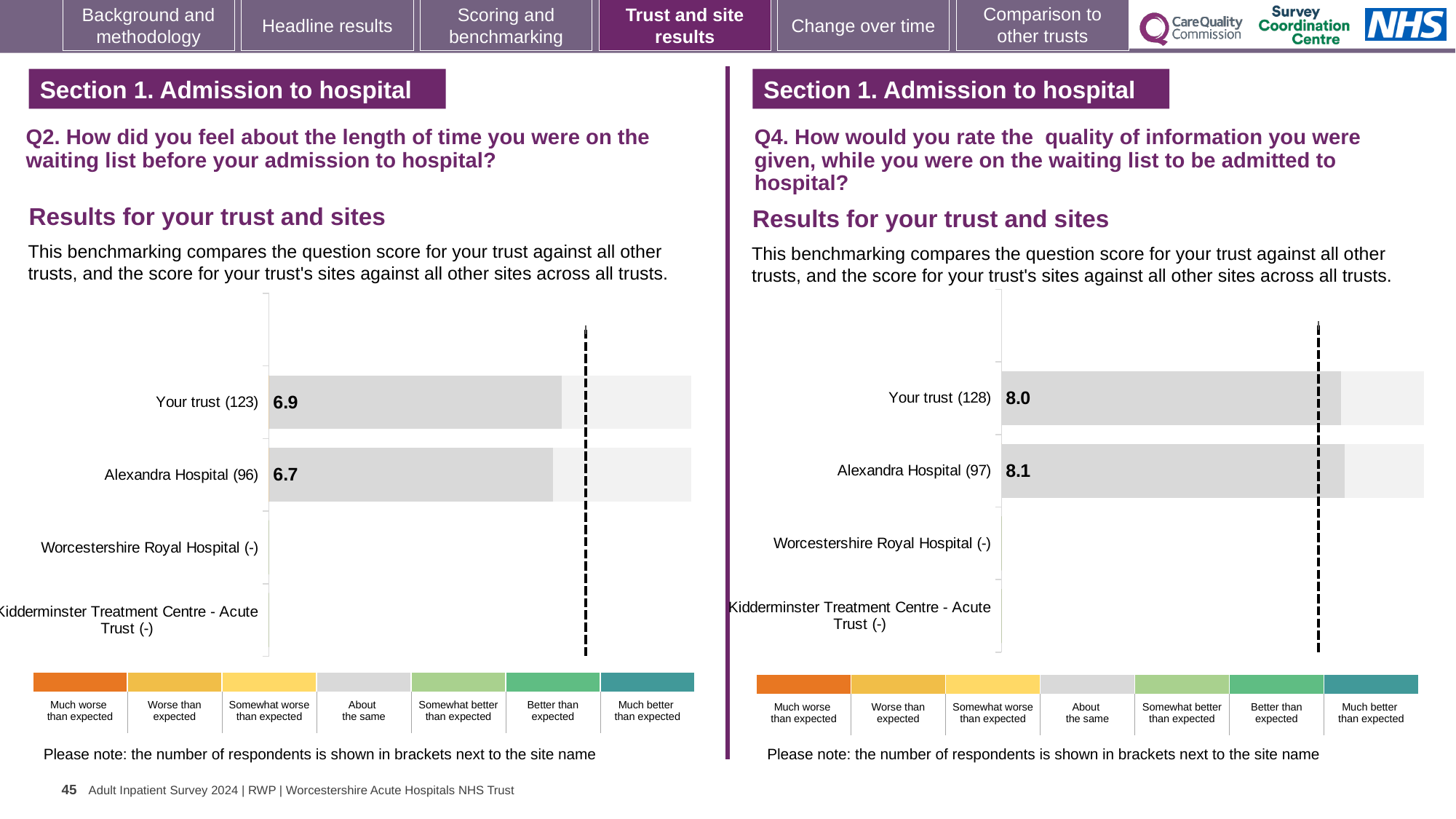
On the Q4 chart (right), how many respondents are shown in brackets for Alexandra Hospital? 97 On the Q4 chart (right), what is the score for Your trust? 8.0 On the Q2 chart (left), what is the score for Your trust? 6.9 How many site/trust categories are listed on the Q2 chart (left)? 4 On the Q4 chart (right), what is the score for Alexandra Hospital? 8.1 On the Q2 chart (left), which has the higher score, Your trust or Alexandra Hospital? Your trust On the Q2 chart (left), how many respondents are shown in brackets for Your trust? 123 On the Q4 chart (right), what is the difference between the Alexandra Hospital score and the Your trust score? 0.1 On the Q4 chart (right), which has the higher score, Your trust or Alexandra Hospital? Alexandra Hospital What type of chart is used on the Q4 chart (right)? Bar chart On the Q2 chart (left), what is the difference between the Your trust score and the Alexandra Hospital score? 0.2 On the Q2 chart (left), what is the score for Alexandra Hospital? 6.7